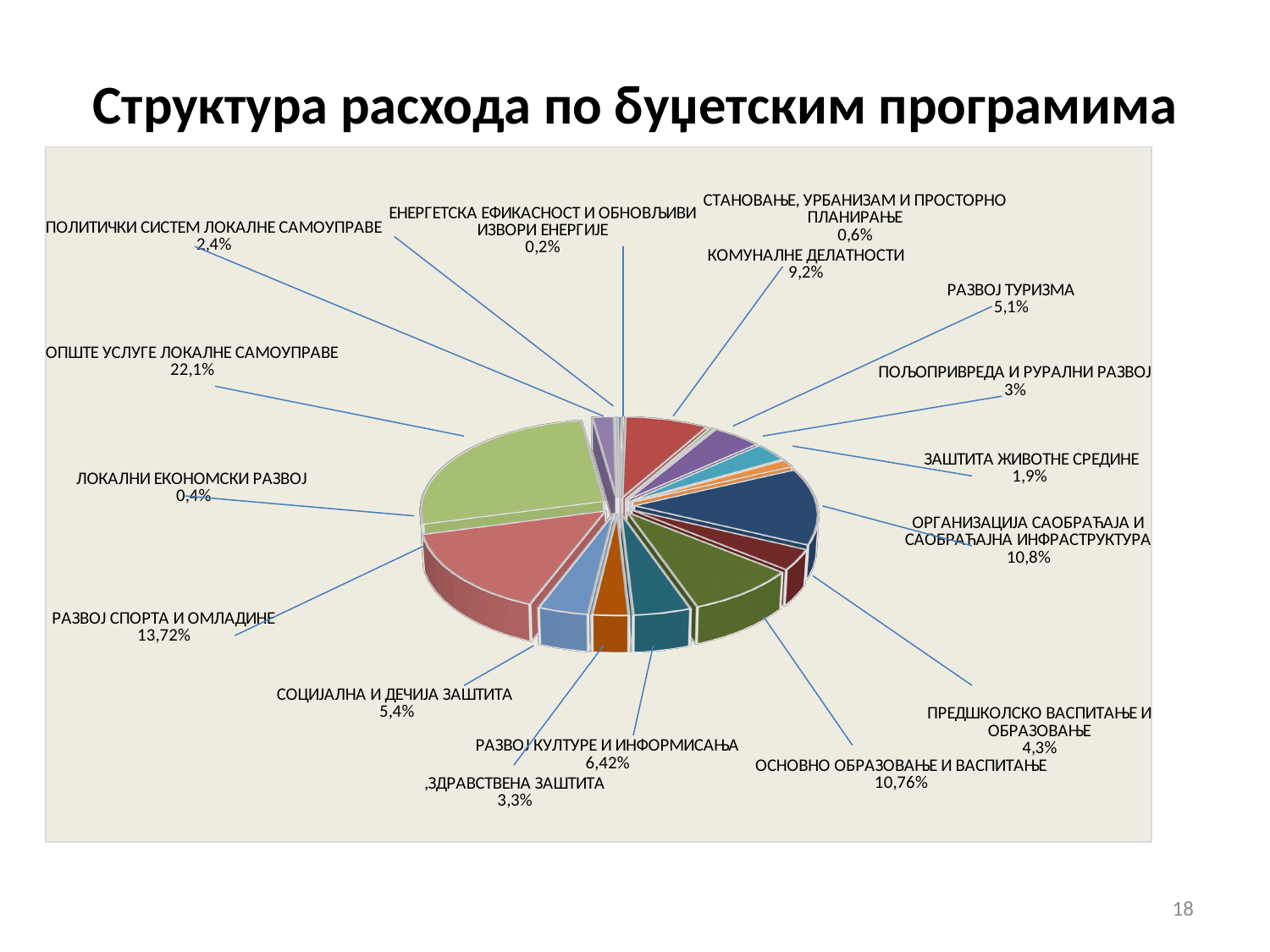
Which category has the largest share of the pie? ОПШТЕ УСЛУГЕ ЛОКАЛНЕ САМОУПРАВЕ Which is larger: РАЗВОЈ ТУРИЗМА or ПРЕДШКОЛСКО ВАСПИТАЊЕ И ОБРАЗОВАЊЕ? РАЗВОЈ ТУРИЗМА What is the difference between the shares of ОПШТЕ УСЛУГЕ ЛОКАЛНЕ САМОУПРАВЕ and РАЗВОЈ СПОРТА И ОМЛАДИНЕ? 8,38% How many slices (categories) does the pie chart have? 16 What is the value shown for РАЗВОЈ КУЛТУРЕ И ИНФОРМИСАЊА? 6,42% What share of the pie does РАЗВОЈ СПОРТА И ОМЛАДИНЕ have? 13,72% What kind of chart is shown on the slide? pie chart What is the title of the chart on the slide? Структура расхода по буџетским програмима What is the value shown for ЛОКАЛНИ ЕКОНОМСКИ РАЗВОЈ? 0,4% Which category has the smallest share of the pie? ЕНЕРГЕТСКА ЕФИКАСНОСТ И ОБНОВЉИВИ ИЗВОРИ ЕНЕРГИЈЕ What is the value shown for ОСНОВНО ОБРАЗОВАЊЕ И ВАСПИТАЊЕ? 10,76% What is the value shown for КОМУНАЛНЕ ДЕЛАТНОСТИ? 9,2%